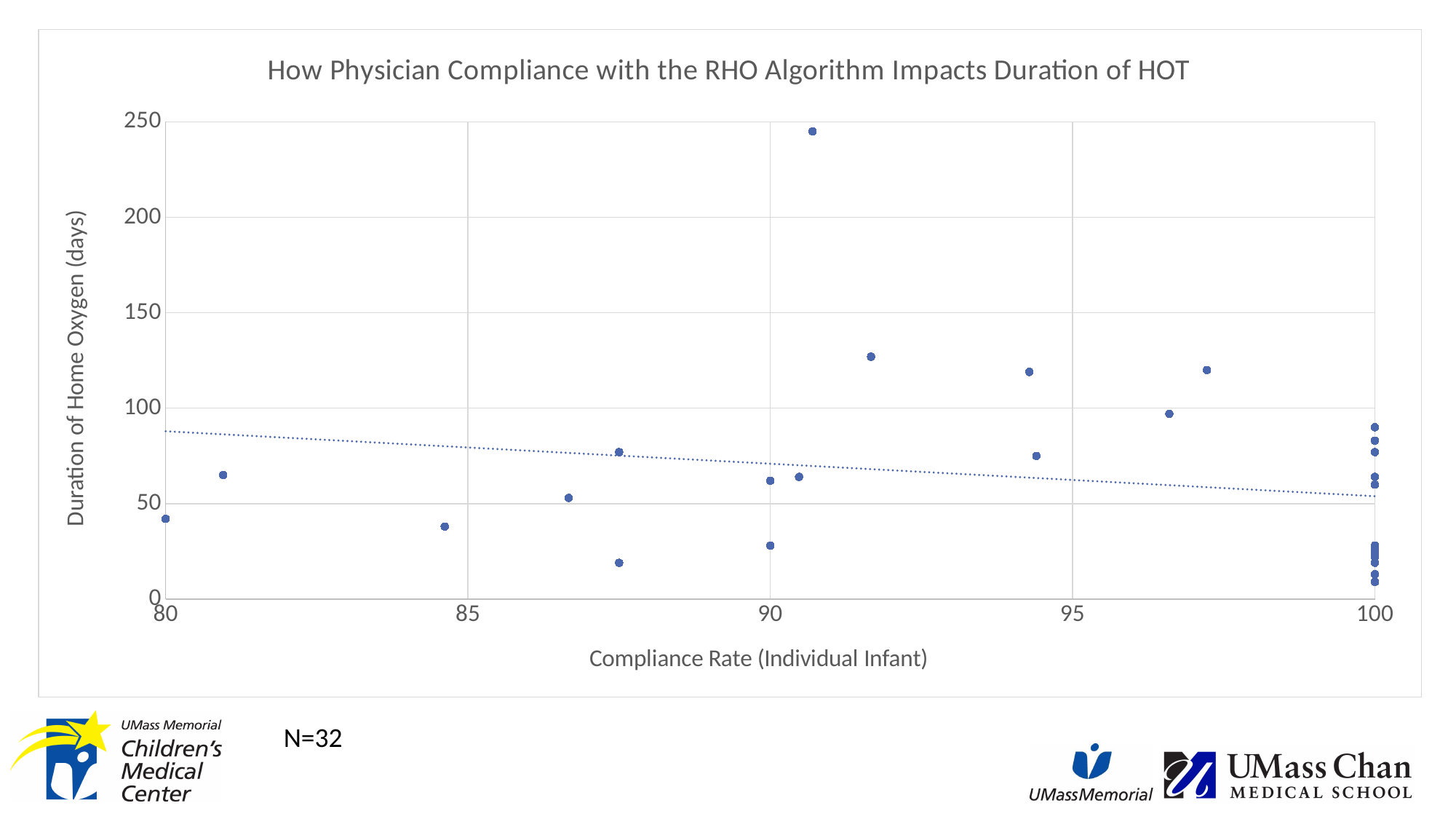
What is the title of the chart? How Physician Compliance with the RHO Algorithm Impacts Duration of HOT Is the duration for the point at a compliance rate of 80 greater or less than 50 days? less Is the duration for the point just below 85 on the x axis greater or less than 50 days? less What is the highest tick value shown on the vertical axis? 250 Is the highest plotted duration of home oxygen greater or less than 200 days? greater How many infants are in the sample according to the N value on the slide? 32 What kind of chart is shown on the slide? Scatter plot At which compliance rate are the most data points clustered? 100 Does the dotted trendline rise or fall as the compliance rate increases? Falls What is the label of the vertical axis? Duration of Home Oxygen (days) Which has the longer duration of home oxygen: the point at a compliance rate of 80 or the point near 81? The point near 81